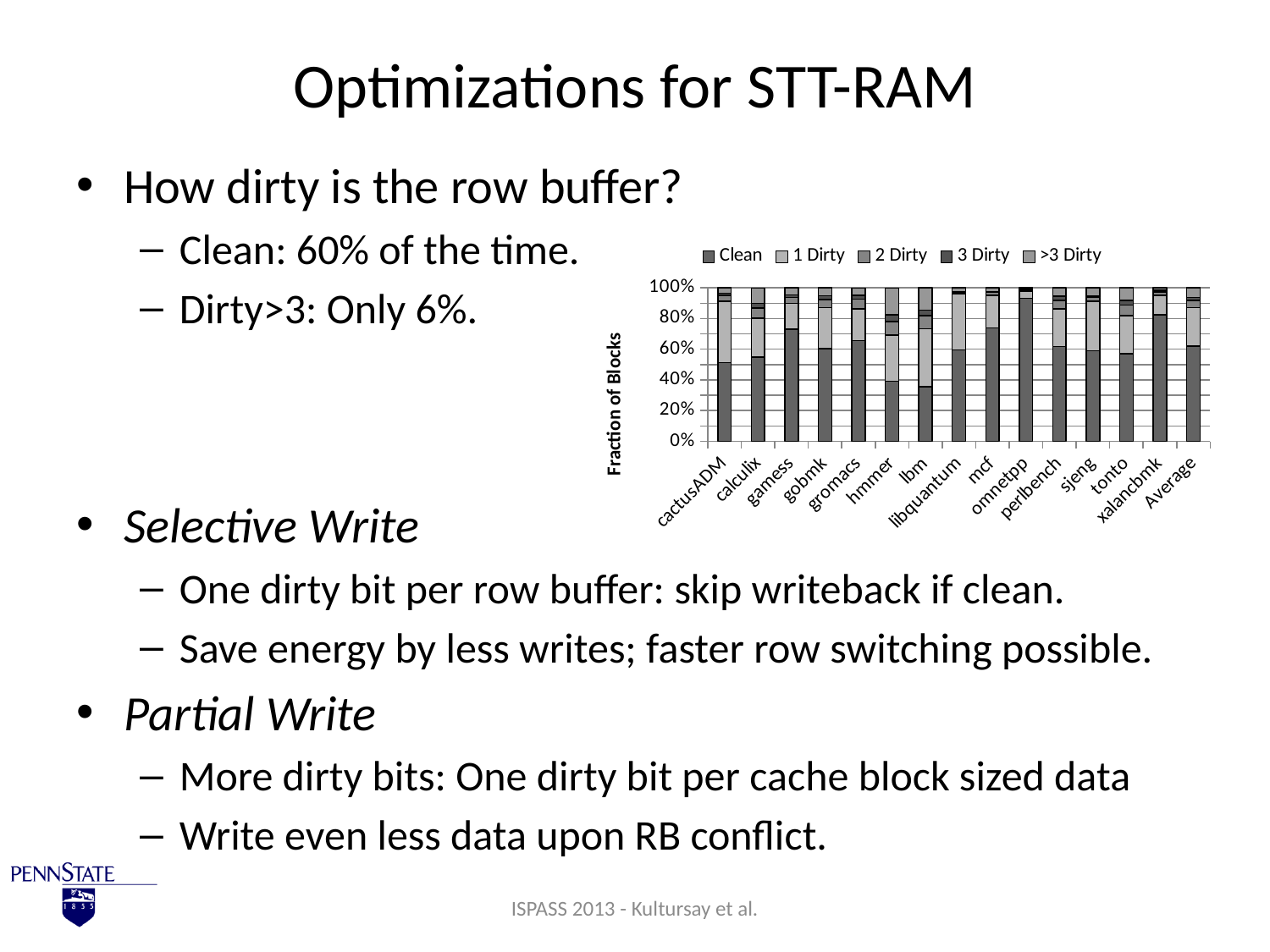
Is the Clean fraction for lbm greater or less than 40%? less What kind of chart is shown on the slide? Stacked bar chart Is the Clean fraction for Average greater or less than 40%? greater Which benchmark has the highest Clean fraction in the chart? omnetpp How many series does the chart legend list? 5 How many benchmark categories (including Average) are shown on the x axis of the chart? 15 Which has a larger Clean fraction, omnetpp or lbm? omnetpp Is the Clean fraction for omnetpp greater or less than 80%? greater What is the y-axis title of the chart? Fraction of Blocks Which has a larger Clean fraction, mcf or calculix? mcf Which series are listed in the chart legend? Clean, 1 Dirty, 2 Dirty, 3 Dirty, >3 Dirty